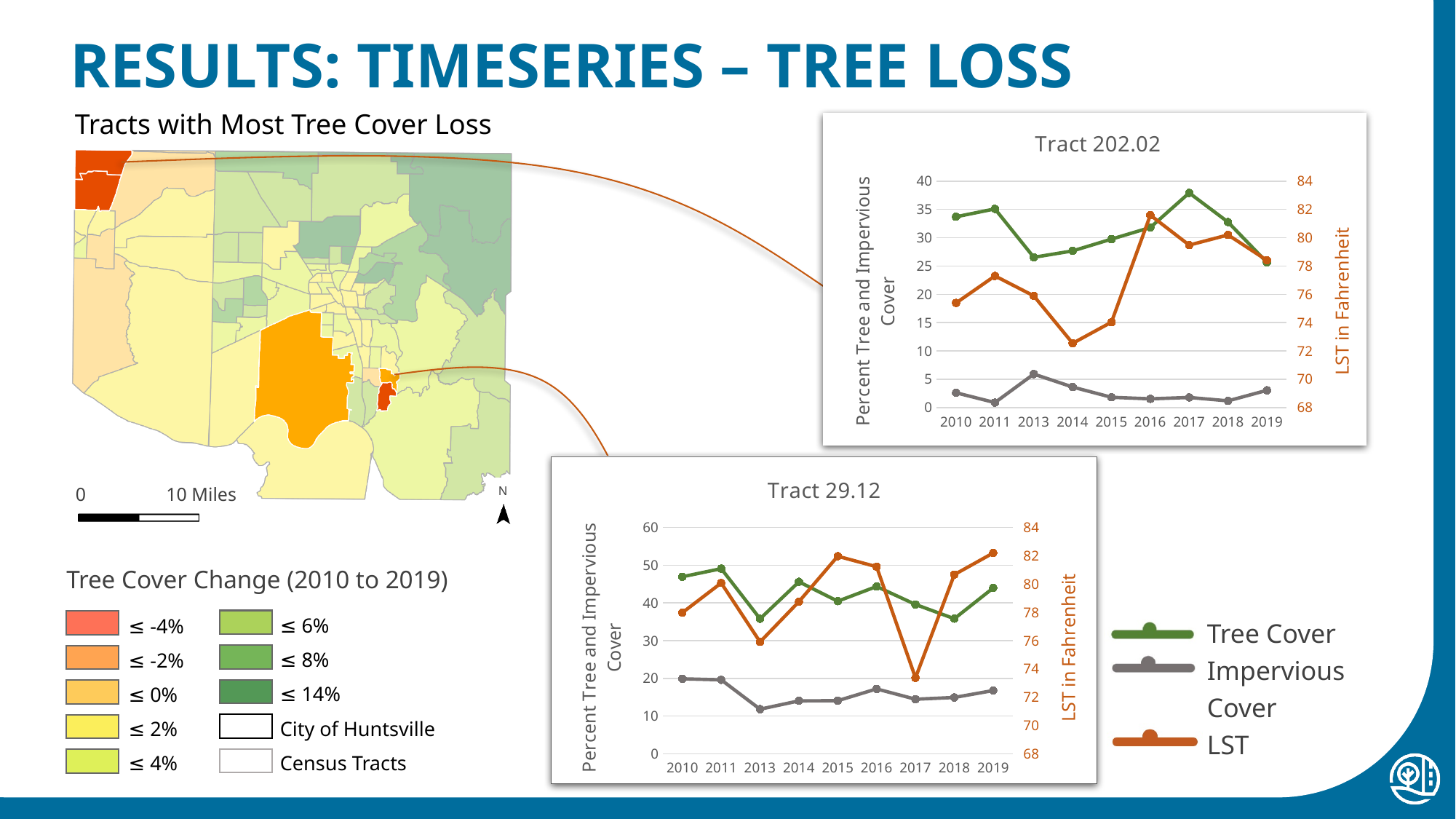
How many series does the legend list for the tract charts? 3 How many years are plotted on the x axis of the Tract 29.12 chart? 9 In the Tract 29.12 chart, does Impervious Cover rise or fall from 2010 to 2013? fall In the Tract 29.12 chart, in which year is Impervious Cover lowest? 2013 In the Tract 29.12 chart, is the Tree Cover value for 2013 greater or less than 40? less In the Tract 29.12 chart, in which year is LST lowest? 2017 In the Tract 202.02 chart, is the Tree Cover value for 2017 greater or less than 35? greater In the Tract 202.02 chart, in which year is Tree Cover highest? 2017 In the Tract 202.02 chart, in which year is Impervious Cover highest? 2013 What kind of chart is the Tract 202.02 chart? line chart In the Tract 202.02 chart, in which year is LST lowest? 2014 In the Tract 202.02 chart, is the LST value for 2014 greater or less than 74? less